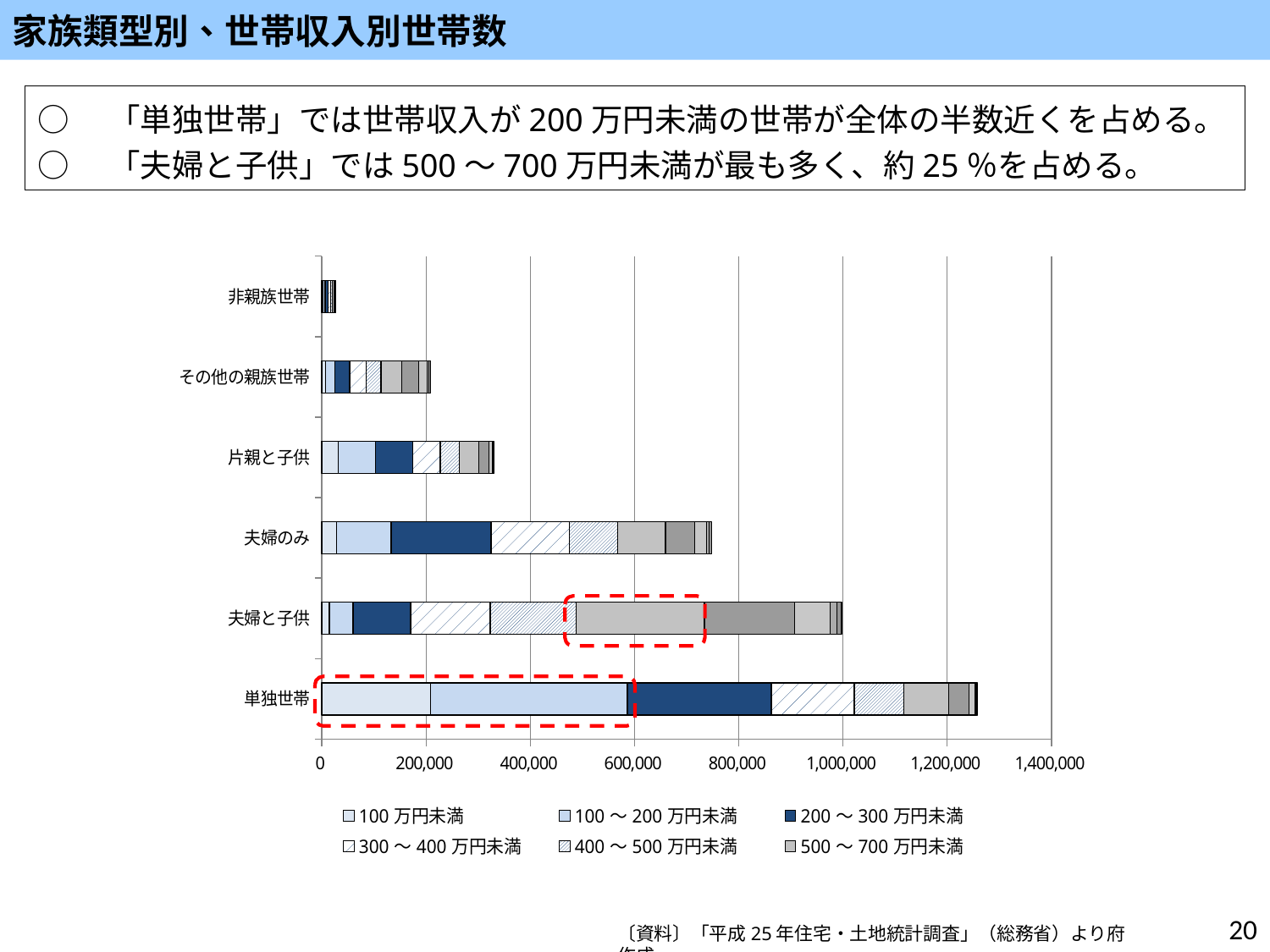
Which family type has the longest total bar? 単独世帯 Which family type has the shortest total bar? 非親族世帯 Is the total bar length for 非親族世帯 greater or less than 200,000? less Which has a longer total bar, 夫婦のみ or 片親と子供? 夫婦のみ What is the title of the slide containing the chart? 家族類型別、世帯収入別世帯数 Is the total bar length for 夫婦のみ greater or less than 800,000? less Is the total bar length for 片親と子供 greater or less than 400,000? less How many series does the chart's legend list? 6 What kind of chart is shown on the slide? stacked bar chart How many family-type categories are plotted on the chart? 6 What is the highest value shown on the chart's horizontal axis? 1,400,000